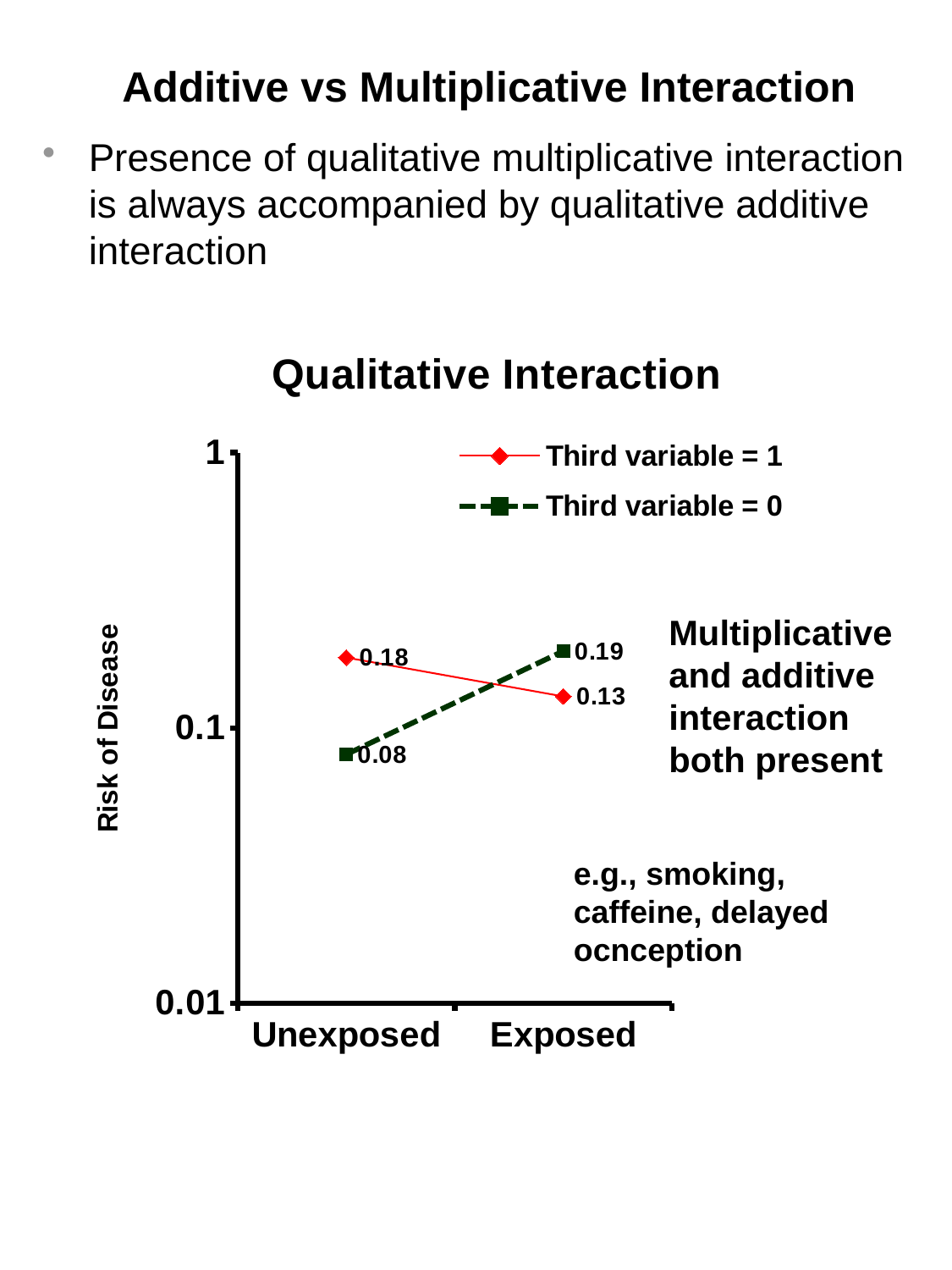
What is the risk of disease for the Exposed group when Third variable = 0? 0.19 What is the title of the chart? Qualitative Interaction Which series has the lower risk of disease in the Unexposed group? Third variable = 0 What is the risk of disease for the Unexposed group when Third variable = 0? 0.08 How many series does the legend list? 2 What type of chart is shown? line chart What is the risk of disease for the Unexposed group when Third variable = 1? 0.18 Which series has the higher risk of disease in the Exposed group? Third variable = 0 Does the risk of disease for Third variable = 1 rise or fall from Unexposed to Exposed? fall What is the difference in risk of disease between Exposed and Unexposed for the Third variable = 0 series? 0.11 What is the difference in risk of disease between Unexposed and Exposed for the Third variable = 1 series? 0.05 What is the risk of disease for the Exposed group when Third variable = 1? 0.13